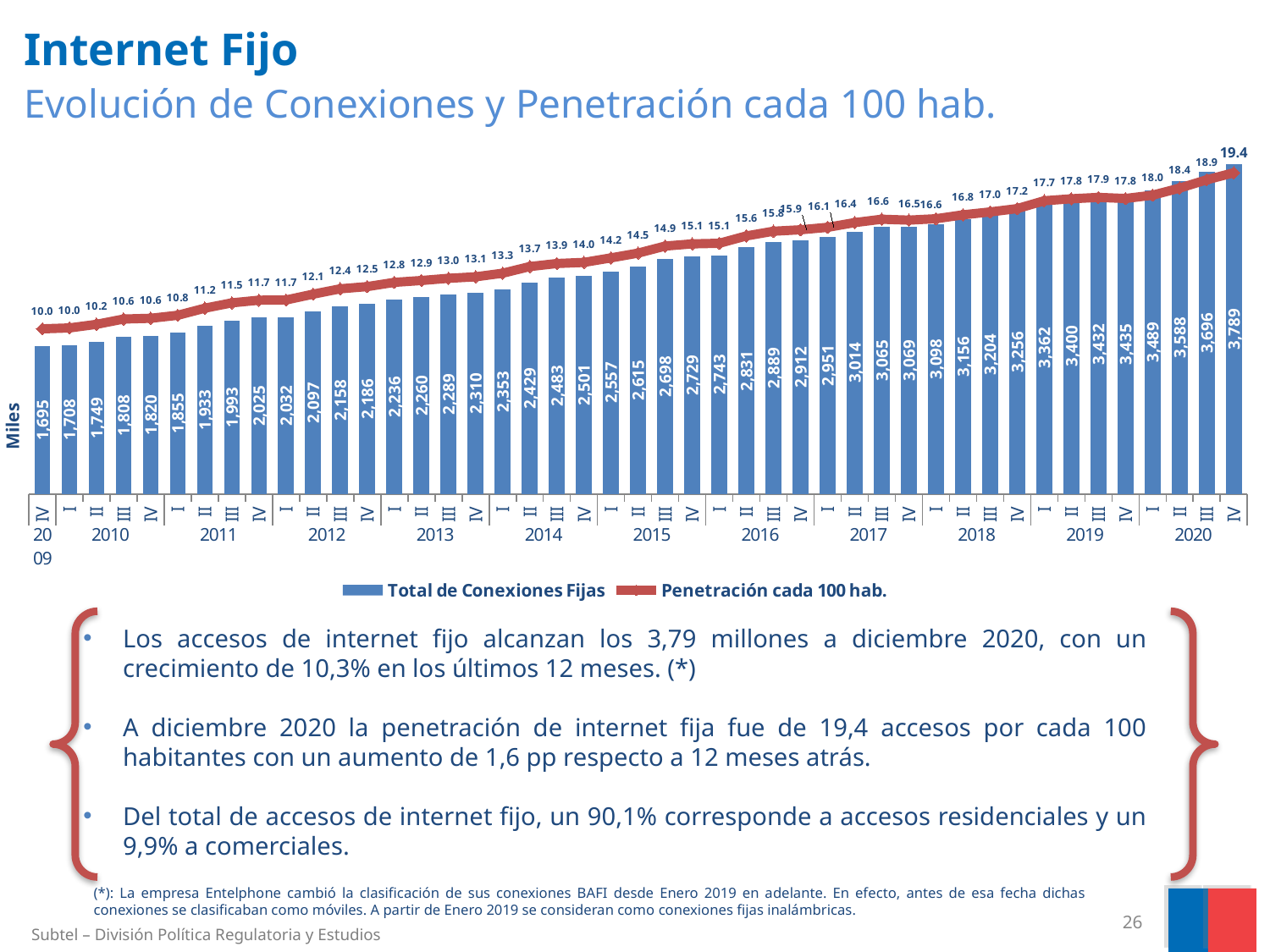
How many series does the legend list? 2 What kind of chart is shown on the slide? Combined bar and line chart Which quarter has the lowest Total de Conexiones Fijas? IV 2009 Do the Total de Conexiones Fijas values rise or fall from IV 2009 to IV 2020? Rise Which quarter has the highest Total de Conexiones Fijas? IV 2020 What is the Penetración cada 100 hab. value for IV 2020? 19.4 Which is larger, Total de Conexiones Fijas in IV 2015 or in IV 2010? IV 2015 What is the value of Total de Conexiones Fijas for IV 2009? 1,695 By how much did Penetración cada 100 hab. increase from IV 2019 to IV 2020? 1.6 What is the value of Total de Conexiones Fijas for IV 2020? 3,789 What is the Penetración cada 100 hab. value for IV 2019? 17.8 What is the difference in Total de Conexiones Fijas between IV 2020 and IV 2019? 354